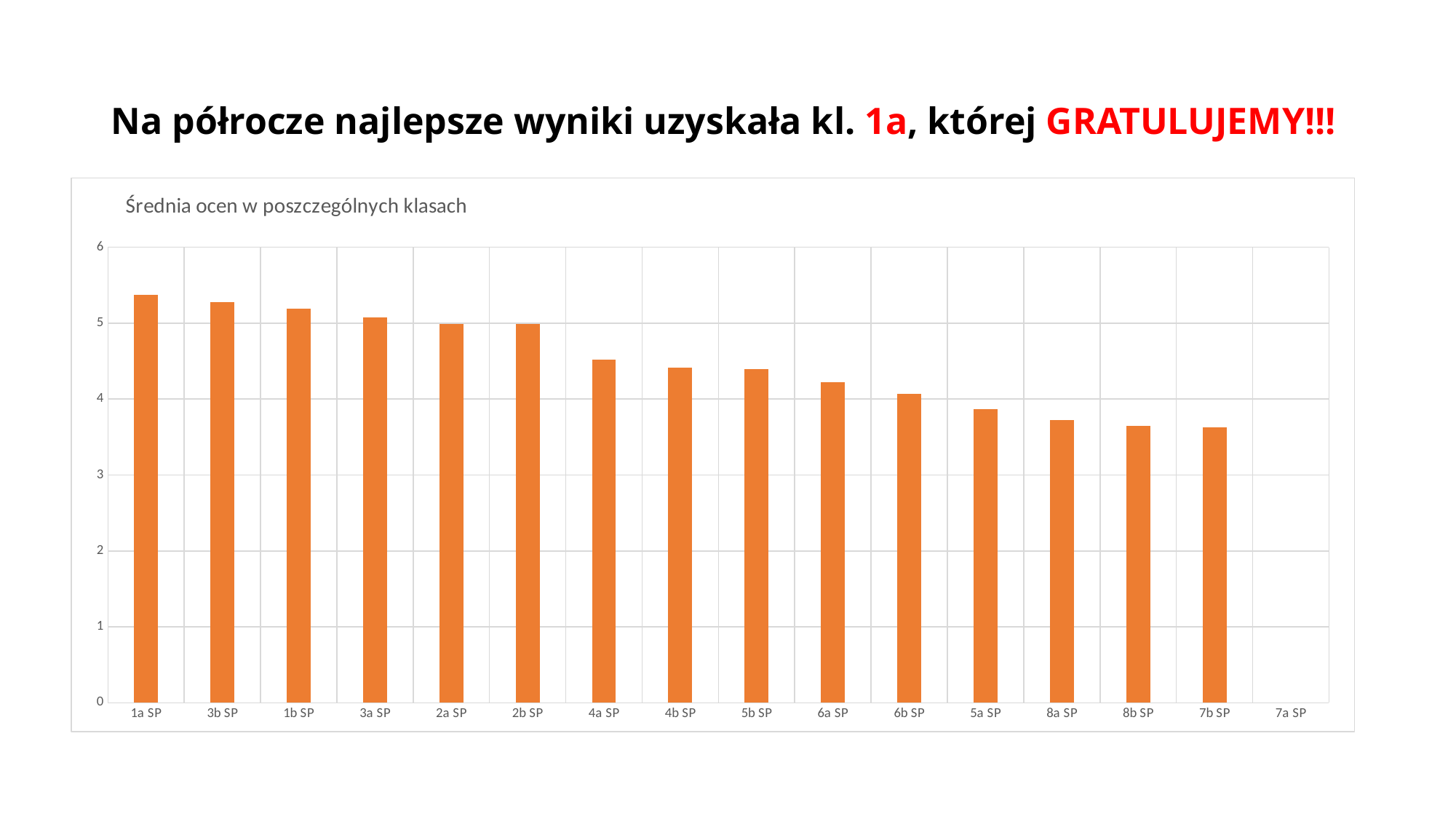
What kind of chart is shown on the slide? bar chart Is the value for 5a SP greater or less than 4? less Which class has the highest average grade in the chart? 1a SP Which class on the x axis has no visible bar in the chart? 7a SP Which has a higher average grade, 3b SP or 6a SP? 3b SP Is the value for 8b SP greater or less than 3? greater Is the value for 4a SP greater or less than 5? less Do the bar values rise or fall from left to right along the x axis? fall How many classes are listed on the x axis of the chart? 16 What is the title of the chart? Średnia ocen w poszczególnych klasach